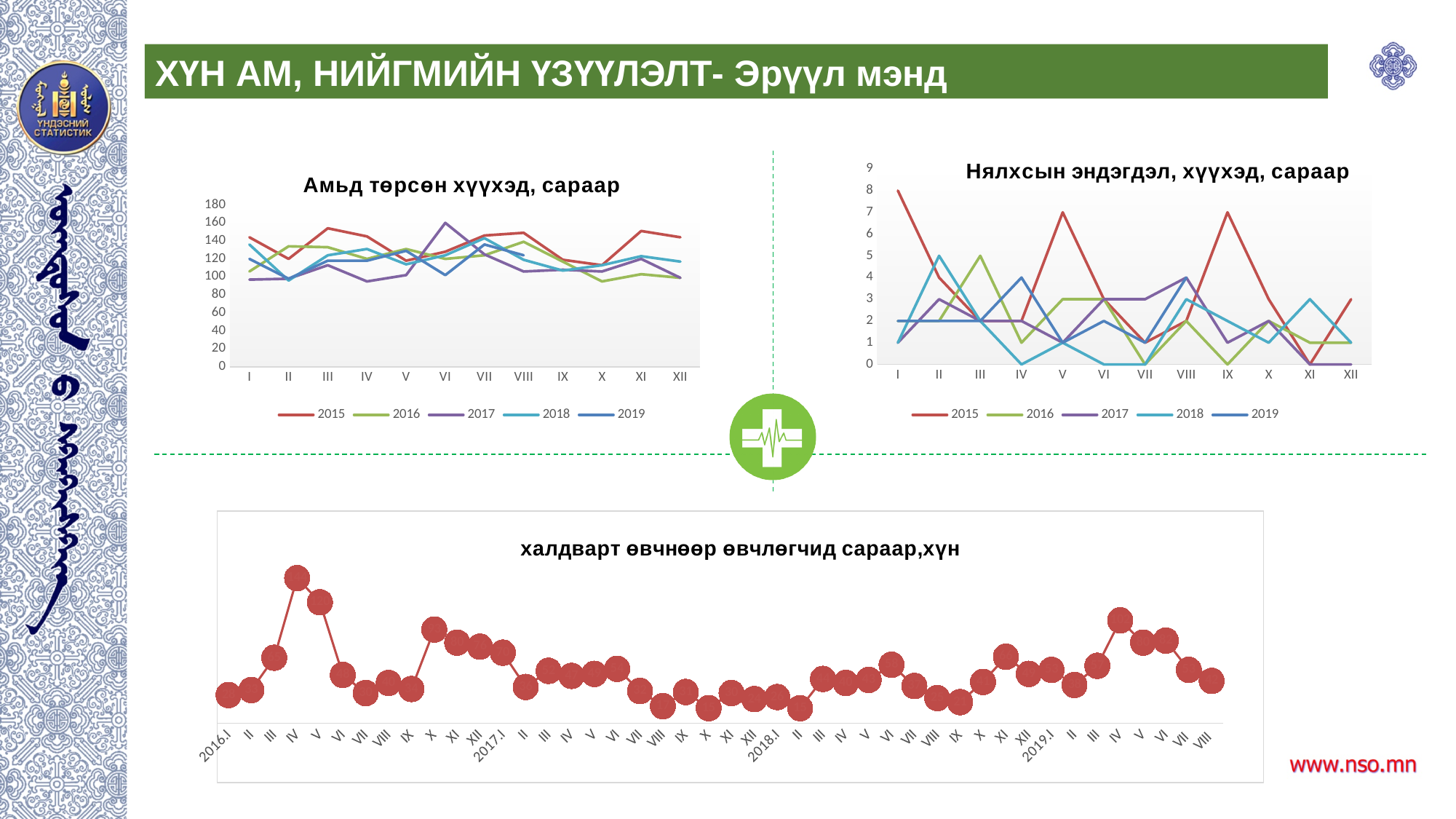
In the "Нялхсын эндэгдэл, хүүхэд, сараар" chart, what is the difference between the 2015 values for month I and month V? 1 In the "Нялхсын эндэгдэл, хүүхэд, сараар" chart, what is the 2016 value for month III? 5 How many series does the legend of the "Амьд төрсөн хүүхэд, сараар" chart list? 5 In the "Нялхсын эндэгдэл, хүүхэд, сараар" chart, what is the 2016 value for month IX? 0 In the "халдварт өвчнөөр өвчлөгчид сараар,хүн" chart, which month has the highest value? 2016.IV How many months are shown on the x axis of the "Амьд төрсөн хүүхэд, сараар" chart? 12 How many data points are plotted in the "халдварт өвчнөөр өвчлөгчид сараар,хүн" chart? 44 In the "Нялхсын эндэгдэл, хүүхэд, сараар" chart, which month has the highest value for 2015? I In the "Амьд төрсөн хүүхэд, сараар" chart, is the 2015 value for month III greater or less than 140? greater In the "Нялхсын эндэгдэл, хүүхэд, сараар" chart, what is the 2015 value for month I? 8 In the "Амьд төрсөн хүүхэд, сараар" chart, is the 2016 value for month X greater or less than 100? less What kind of chart is the "Амьд төрсөн хүүхэд, сараар" chart? line chart